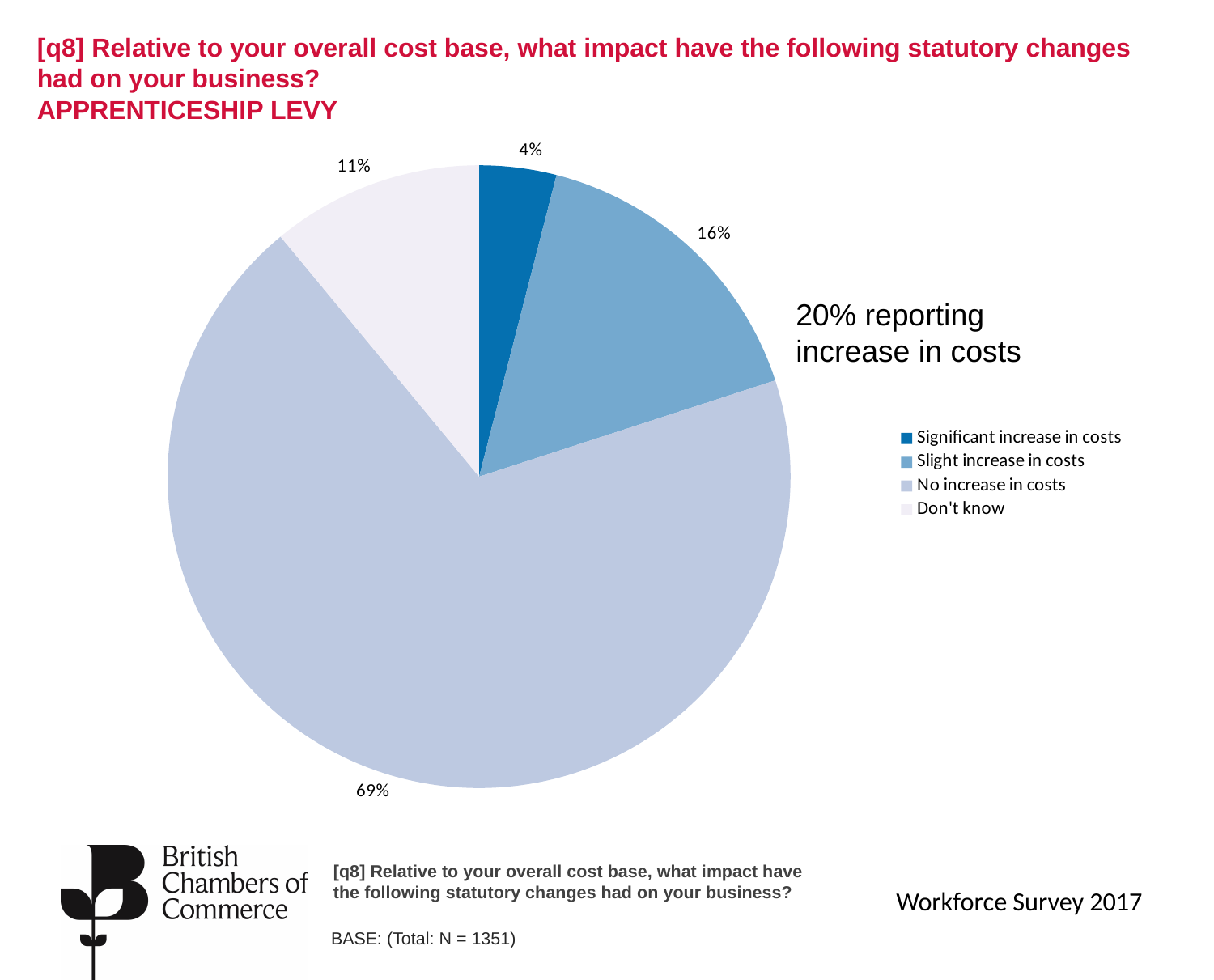
Which response category has the smallest share of the pie? Significant increase in costs What percentage of respondents reported no increase in costs? 69% What is the base size (N) stated on the slide? 1351 Which is larger: the share for 'Slight increase in costs' or the share for 'Don't know'? Slight increase in costs What percentage of respondents reported a significant increase in costs from the Apprenticeship Levy? 4% What is the difference in percentage points between 'No increase in costs' and 'Slight increase in costs'? 53 What percentage of respondents answered 'Don't know'? 11% What is the combined share of respondents reporting a significant or slight increase in costs? 20% What percentage of respondents reported a slight increase in costs? 16% How many categories does the legend list? 4 Which response category has the largest share of the pie? No increase in costs What type of chart is shown on the slide? Pie chart